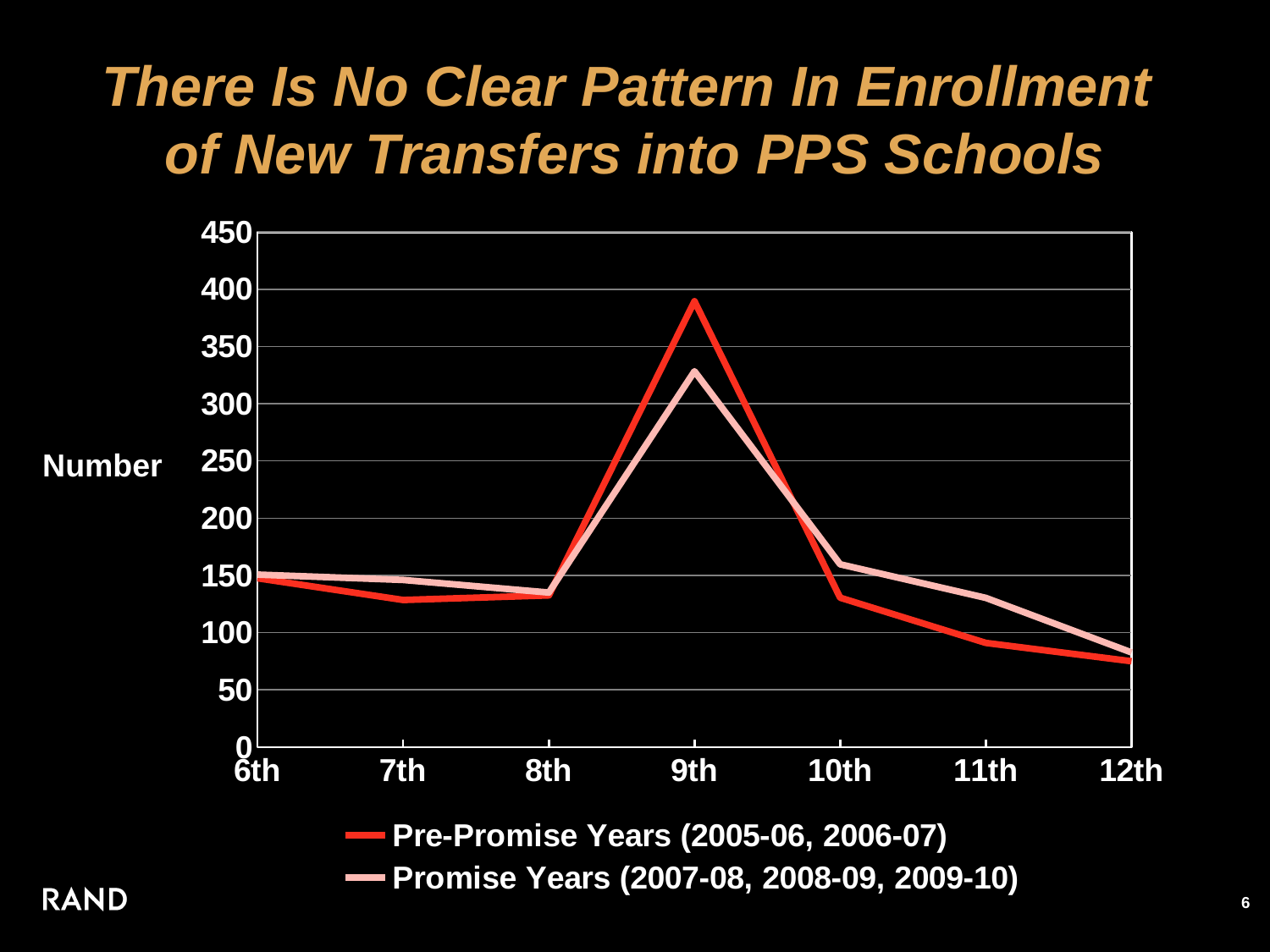
At 11th grade, which series has the higher value, Pre-Promise Years or Promise Years? Promise Years Is the Promise Years value for 9th grade greater or less than 350? less At which grade does the Pre-Promise Years series reach its highest value? 9th At which grade is the Promise Years series lowest? 12th How many grade levels are plotted along the x axis? 7 At which grade is the Pre-Promise Years series lowest? 12th At which grade does the Promise Years series reach its highest value? 9th Is the Pre-Promise Years value for 9th grade greater or less than 350? greater How many series does the legend list? 2 What kind of chart is shown on the slide? line chart At 9th grade, which series has the higher value, Pre-Promise Years or Promise Years? Pre-Promise Years From 9th grade to 12th grade, does the Pre-Promise Years series rise or fall? fall